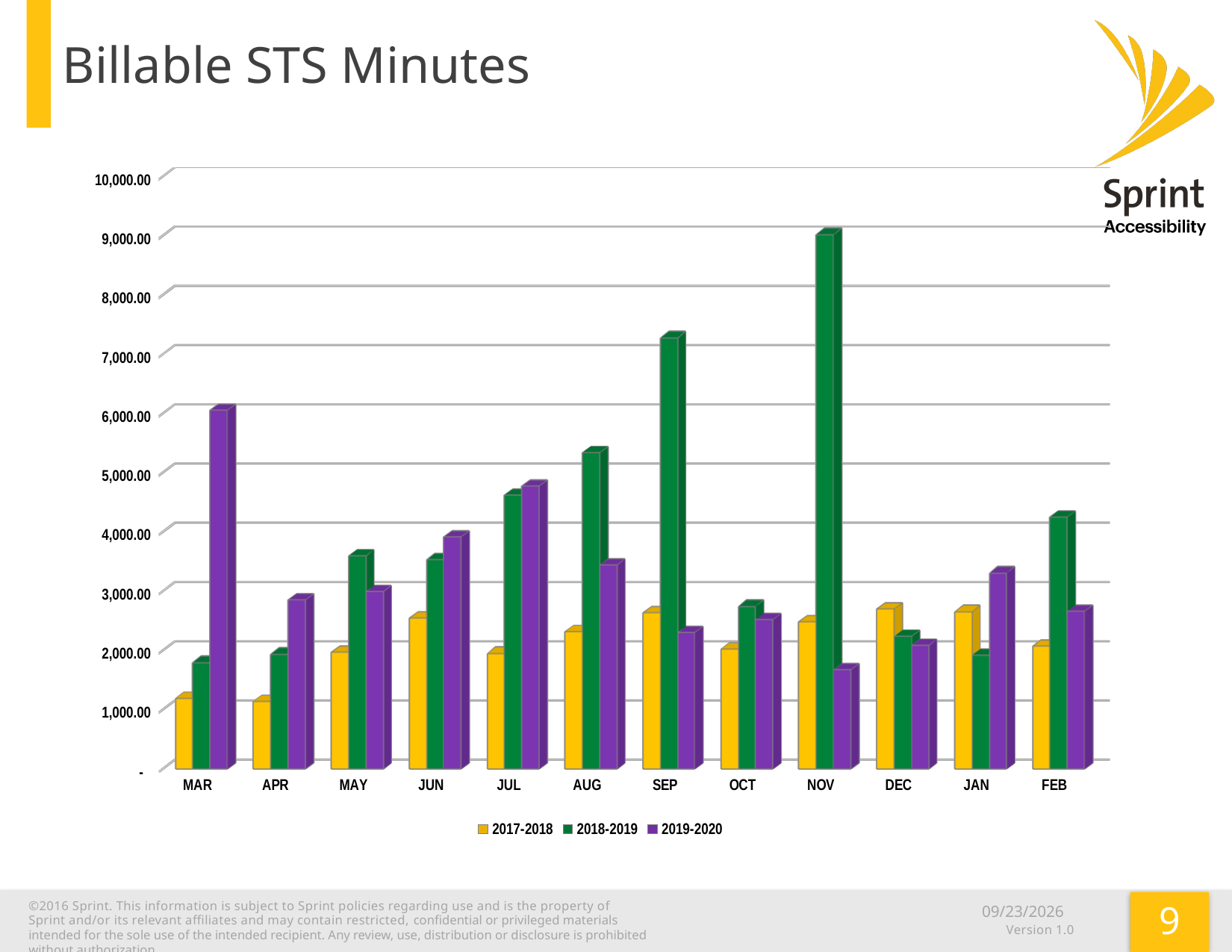
Is the 2018-2019 value for SEP greater or less than 6,000.00? greater Which month has the lowest value for the 2019-2020 series? NOV Is the 2017-2018 value for MAR greater or less than 2,000.00? less What kind of chart is shown on the slide? bar chart How many series does the legend list? 3 Is the 2019-2020 value for MAR greater or less than 5,000.00? greater How many months are shown on the x axis? 12 In JAN, which series has the larger value, 2018-2019 or 2019-2020? 2019-2020 Which month has the highest value for the 2019-2020 series? MAR In SEP, which series has the larger value, 2017-2018 or 2018-2019? 2018-2019 Which month has the highest value for the 2018-2019 series? NOV